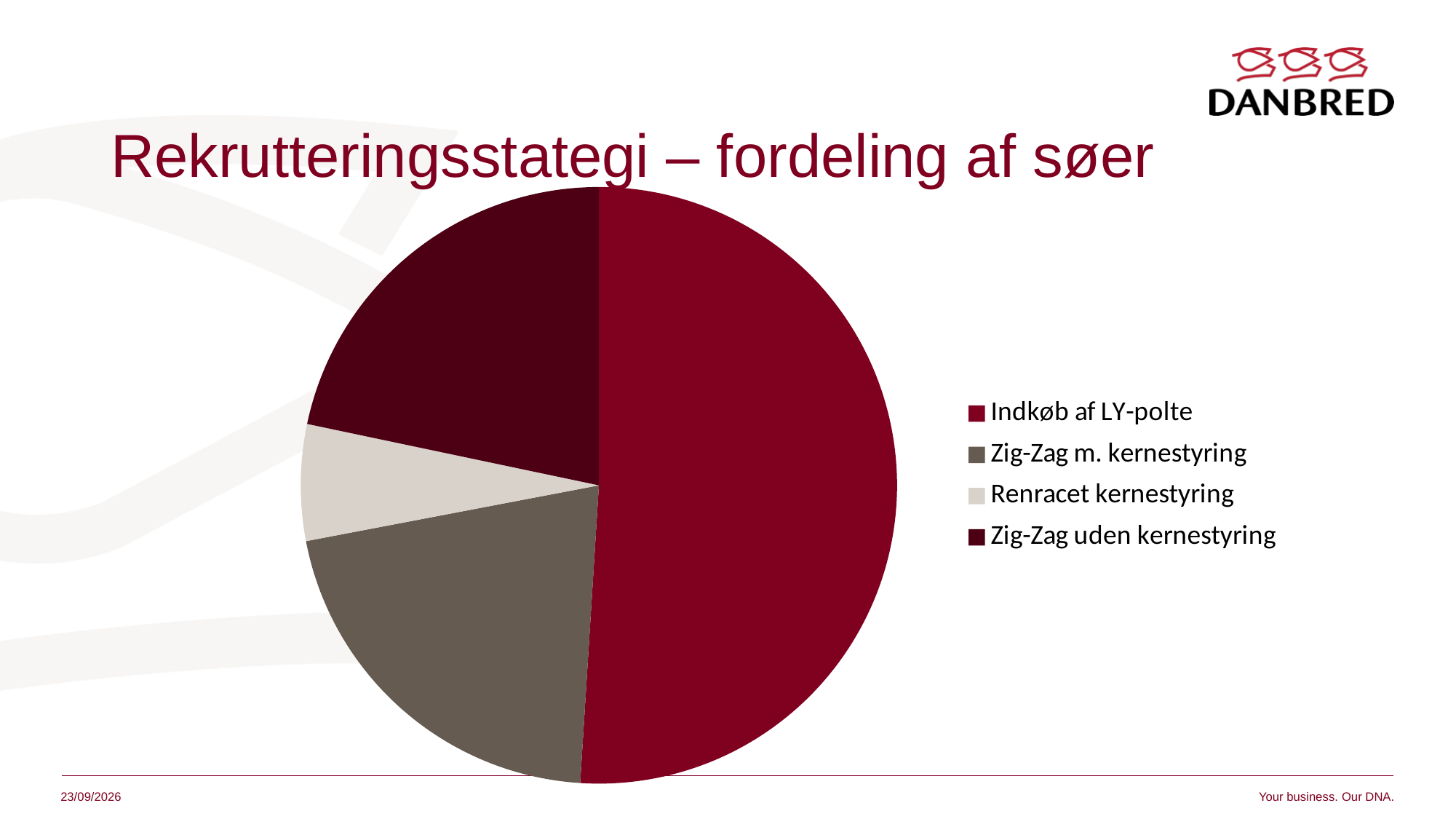
What is the title of the slide containing the pie chart? Rekrutteringsstategi – fordeling af søer What kind of chart is shown on the slide? Pie chart Which category has the smallest slice of the pie chart? Renracet kernestyring Does the Indkøb af LY-polte slice take up more or less than a quarter of the pie? More How many slices does the pie chart have? 4 Which slice is larger: Indkøb af LY-polte or Zig-Zag uden kernestyring? Indkøb af LY-polte Which legend entry is shown in the lightest colour in the pie chart? Renracet kernestyring Which category has the largest slice of the pie chart? Indkøb af LY-polte Which slice is larger: Zig-Zag m. kernestyring or Renracet kernestyring? Zig-Zag m. kernestyring How many entries does the legend of the pie chart list? 4